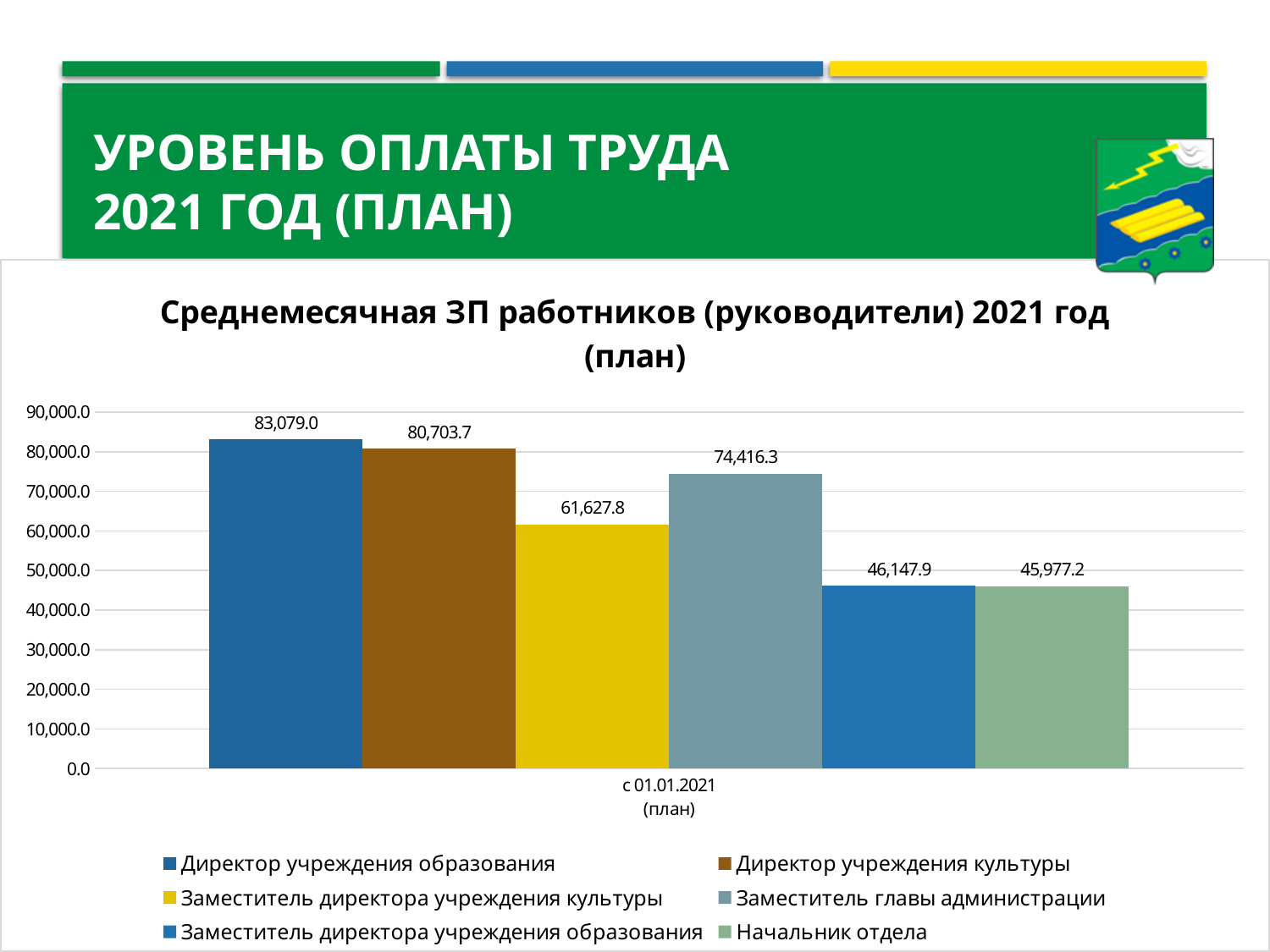
What is the value shown for Начальник отдела? 45,977.2 What is the difference between the values for Заместитель главы администрации and Заместитель директора учреждения культуры? 12,788.5 Is the value for Заместитель директора учреждения образования greater or less than 50,000.0? less What kind of chart is shown on the slide? Bar chart Which is larger: the value for Заместитель главы администрации or for Заместитель директора учреждения культуры? Заместитель главы администрации How many series does the legend list? 6 Which position has the lowest planned average monthly salary? Начальник отдела What is the planned average monthly salary for Директор учреждения образования? 83,079.0 What is the difference between the values for Директор учреждения образования and Директор учреждения культуры? 2,375.3 What is the value shown for Заместитель директора учреждения культуры? 61,627.8 Which position has the highest planned average monthly salary? Директор учреждения образования What is the value shown for Заместитель главы администрации? 74,416.3